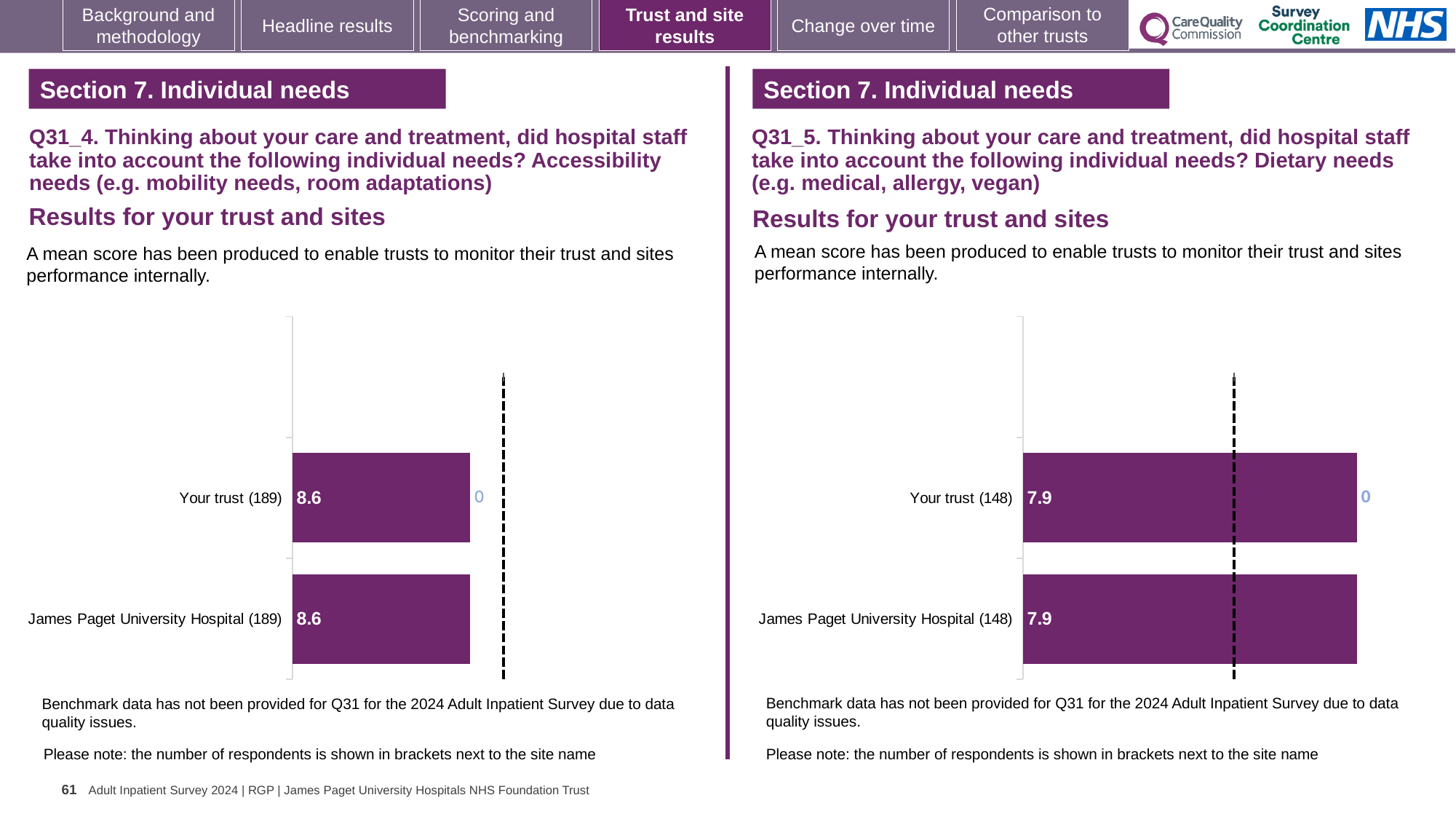
On the right chart (Q31_5, dietary needs), what is the mean score for James Paget University Hospital? 7.9 On the right chart (Q31_5, dietary needs), what is the difference between the scores for Your trust and James Paget University Hospital? 0.0 Is the score for Your trust on the left chart (Q31_4) larger or smaller than the score for Your trust on the right chart (Q31_5)? Larger On the left chart (Q31_4, accessibility needs), how many respondents are shown in brackets for Your trust? 189 On the left chart (Q31_4, accessibility needs), what is the mean score for James Paget University Hospital? 8.6 On the right chart (Q31_5, dietary needs), what is the mean score for Your trust? 7.9 How many bars are plotted on the right chart (Q31_5, dietary needs)? 2 On the left chart (Q31_4, accessibility needs), what is the difference between the scores for Your trust and James Paget University Hospital? 0.0 On the right chart (Q31_5, dietary needs), how many respondents are shown in brackets for James Paget University Hospital? 148 On the left chart (Q31_4, accessibility needs), what is the mean score for Your trust? 8.6 What type of chart is used on the right (Q31_5, dietary needs)? Bar chart How many bars are plotted on the left chart (Q31_4, accessibility needs)? 2